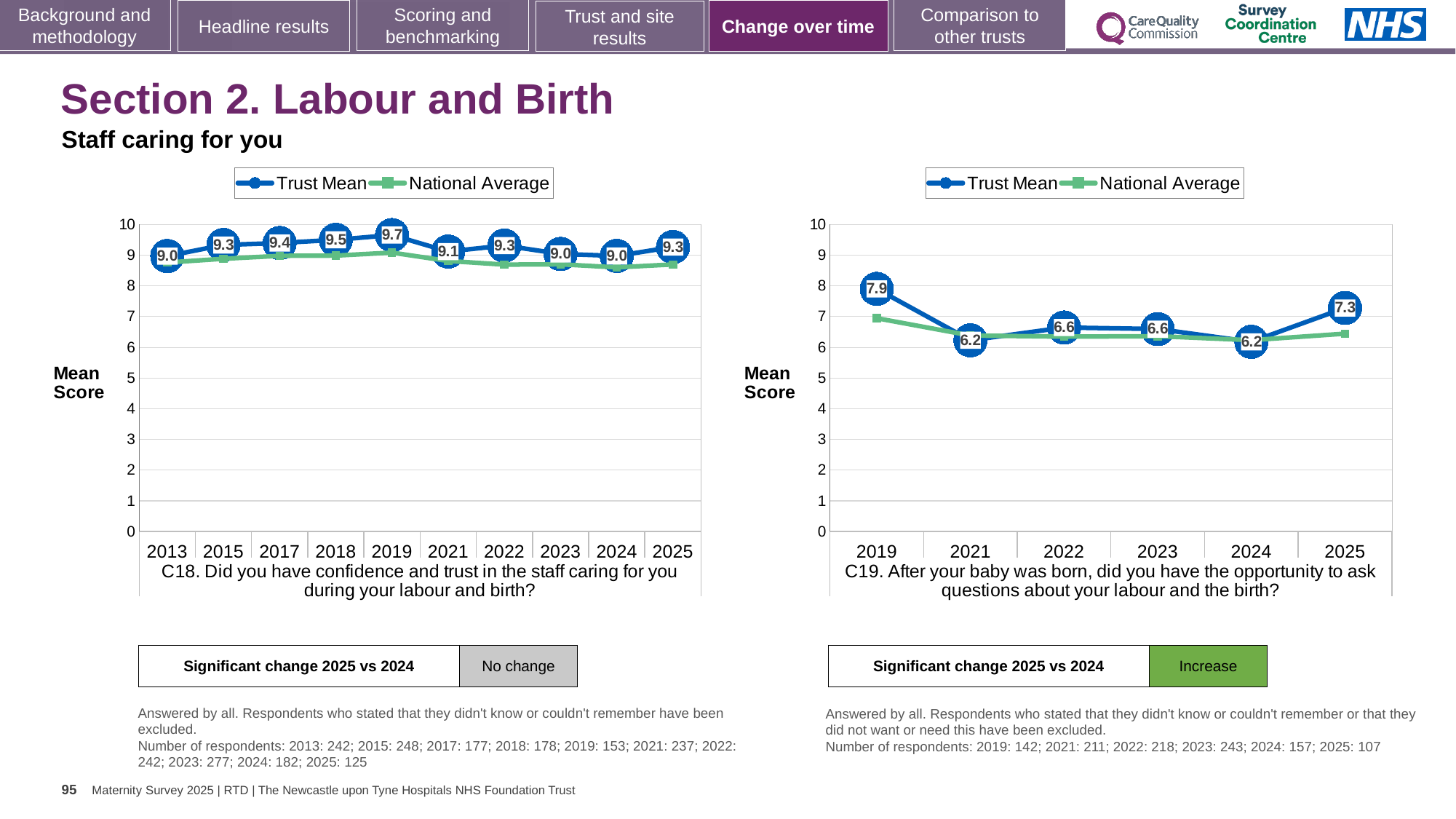
In the C19 chart on the right, what is the difference between the Trust Mean in 2025 and in 2024? 1.1 In the C19 chart on the right, what is the Trust Mean for 2019? 7.9 In the C18 chart on the left, which year has the highest Trust Mean? 2019 In the C18 chart on the left, what is the Trust Mean for 2019? 9.7 In the C18 chart on the left, what is the difference between the Trust Mean in 2019 and in 2021? 0.6 In the C19 chart on the right, is the National Average for 2019 greater or less than 8? less In the C19 chart on the right, what is the Trust Mean for 2025? 7.3 In the C19 chart on the right, which year has the highest Trust Mean? 2019 How many series does the legend of the C19 chart on the right list? 2 In the C18 chart on the left, how many years are plotted on the x axis? 10 In the C18 chart on the left, what is the Trust Mean for 2025? 9.3 What kind of chart is the C18 chart on the left? Line chart